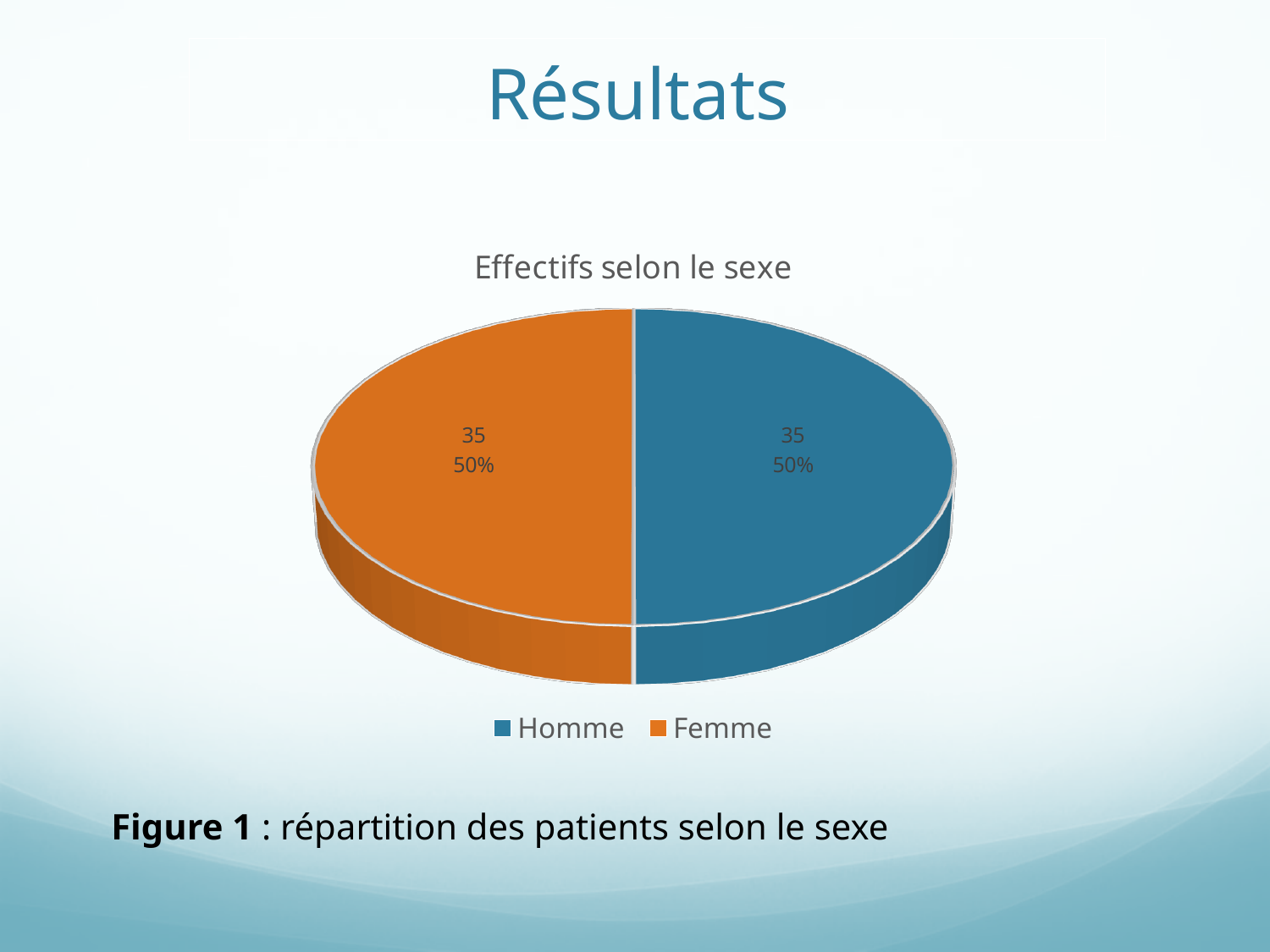
What share of the pie does the Femme slice represent? 50% What is the value for Homme? 35 How many slices does the pie chart have? 2 What is the title of the chart? Effectifs selon le sexe How many entries does the legend list? 2 What is the value for Femme? 35 What is the difference between the values for Homme and Femme? 0 Which colour represents Femme in the chart? orange What is the total of the values for Homme and Femme? 70 What share of the pie does the Homme slice represent? 50% What kind of chart is shown on the slide? pie chart